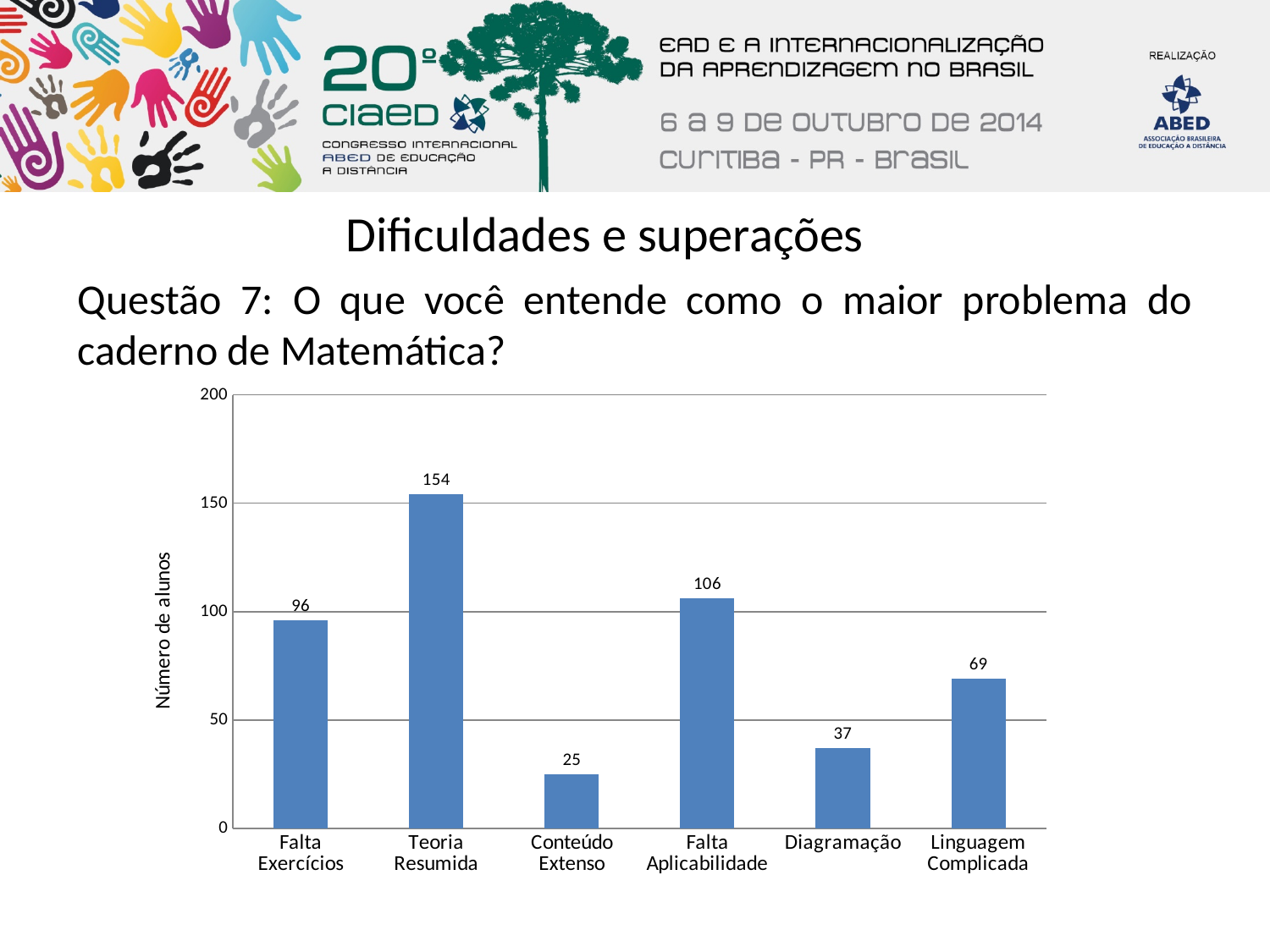
What is the value for Teoria Resumida? 154 What is the value for Conteúdo Extenso? 25 What is the difference between the values for Teoria Resumida and Falta Aplicabilidade? 48 What is the difference between the values for Falta Exercícios and Diagramação? 59 What kind of chart is shown on the slide? bar chart How many categories are shown on the x axis? 6 Which category has the highest value? Teoria Resumida Which category has the lowest value? Conteúdo Extenso What is the value for Linguagem Complicada? 69 Which is larger, the value for Falta Exercícios or the value for Linguagem Complicada? Falta Exercícios Is the value for Diagramação greater or less than 50? less What is the label of the vertical axis? Número de alunos